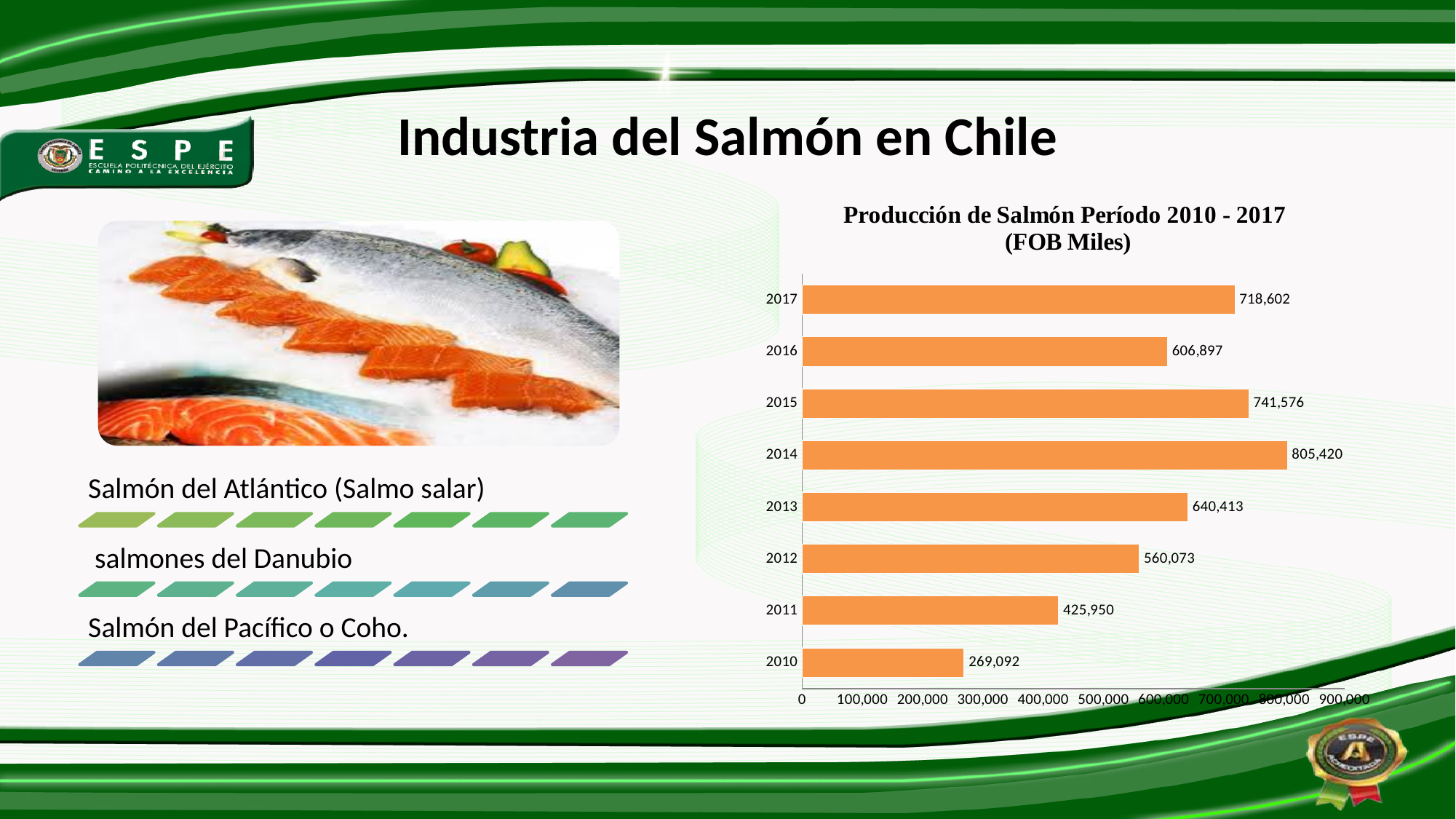
What is the difference between the values for 2011 and 2010? 156,858 Which year has the highest value? 2014 What kind of chart is shown on the slide? bar chart What is the value for 2010? 269,092 Which is larger, the value for 2015 or the value for 2013? 2015 What is the value for 2016? 606,897 What is the difference between the values for 2017 and 2016? 111,705 What is the title of the chart? Producción de Salmón Período 2010 - 2017 (FOB Miles) Is the value for 2012 greater or less than 500,000? greater Which year has the lowest value? 2010 What is the value for 2014? 805,420 How many years are shown in the chart? 8